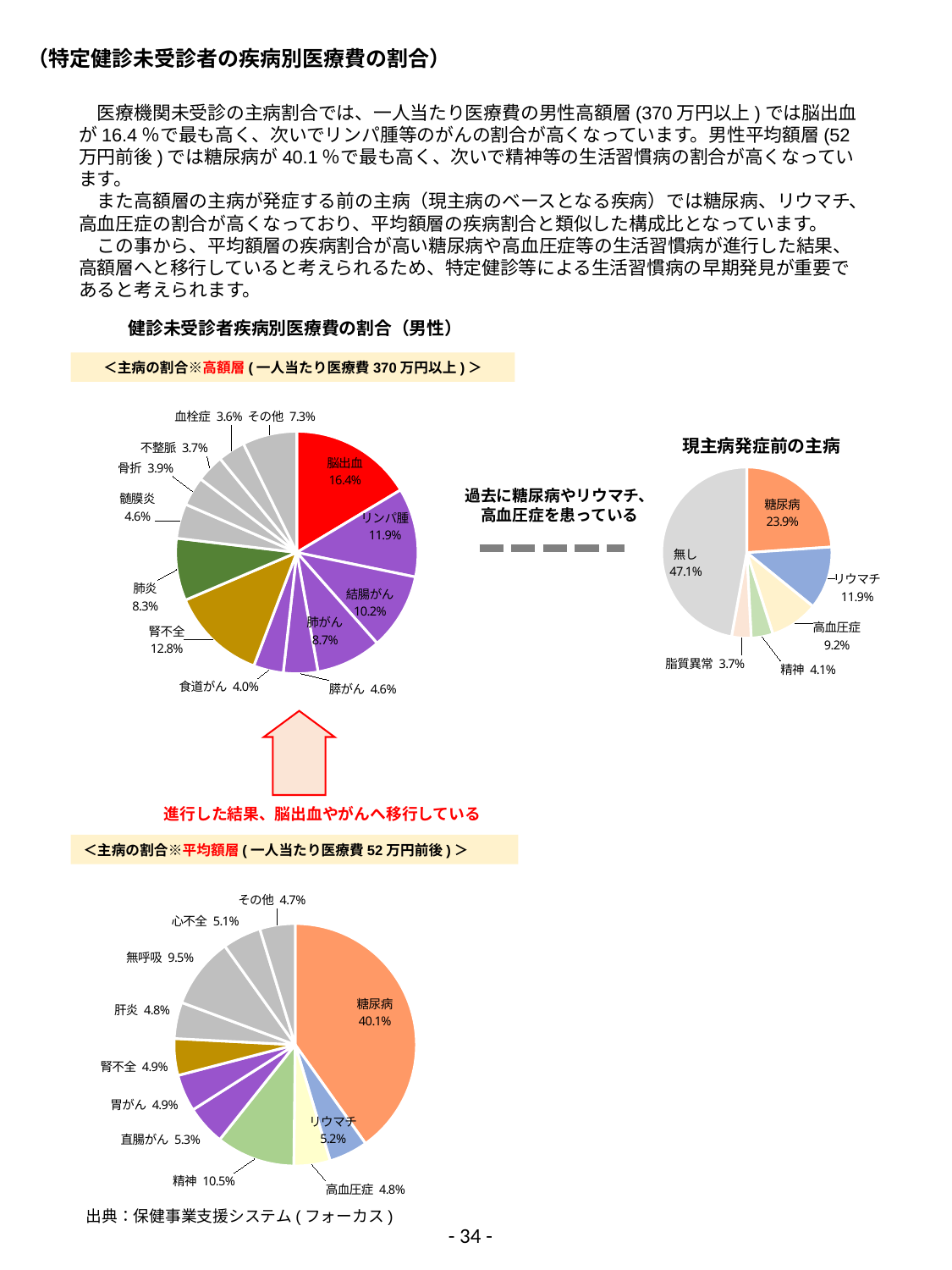
「主病の割合※平均額層」の円グラフで、糖尿病の割合はいくらですか？ 40.1% 「主病の割合※平均額層」の円グラフで、2番目に割合が高い疾病はどれですか？ 精神 このスライドの「主病の割合※高額層」のグラフはどの種類のグラフですか？ 円グラフ 「現主病発症前の主病」の円グラフで、最も割合が高い区分はどれですか？ 無し 「主病の割合※高額層」の円グラフで、最も割合が高い疾病はどれですか？ 脳出血 「現主病発症前の主病」の円グラフで、糖尿病の割合はいくらですか？ 23.9% 「主病の割合※高額層」の円グラフには、いくつの区分がありますか？ 13 「主病の割合※高額層」の円グラフで、腎不全と肺炎の割合の差はいくらですか？ 4.5% 「主病の割合※高額層」の円グラフで、脳出血の割合はいくらですか？ 16.4% 「現主病発症前の主病」の円グラフで、リウマチと高血圧症ではどちらの割合が大きいですか？ リウマチ 「主病の割合※高額層」の円グラフで、最も割合が低い疾病はどれですか？ 血栓症 「主病の割合※平均額層」の円グラフには、いくつの区分がありますか？ 11